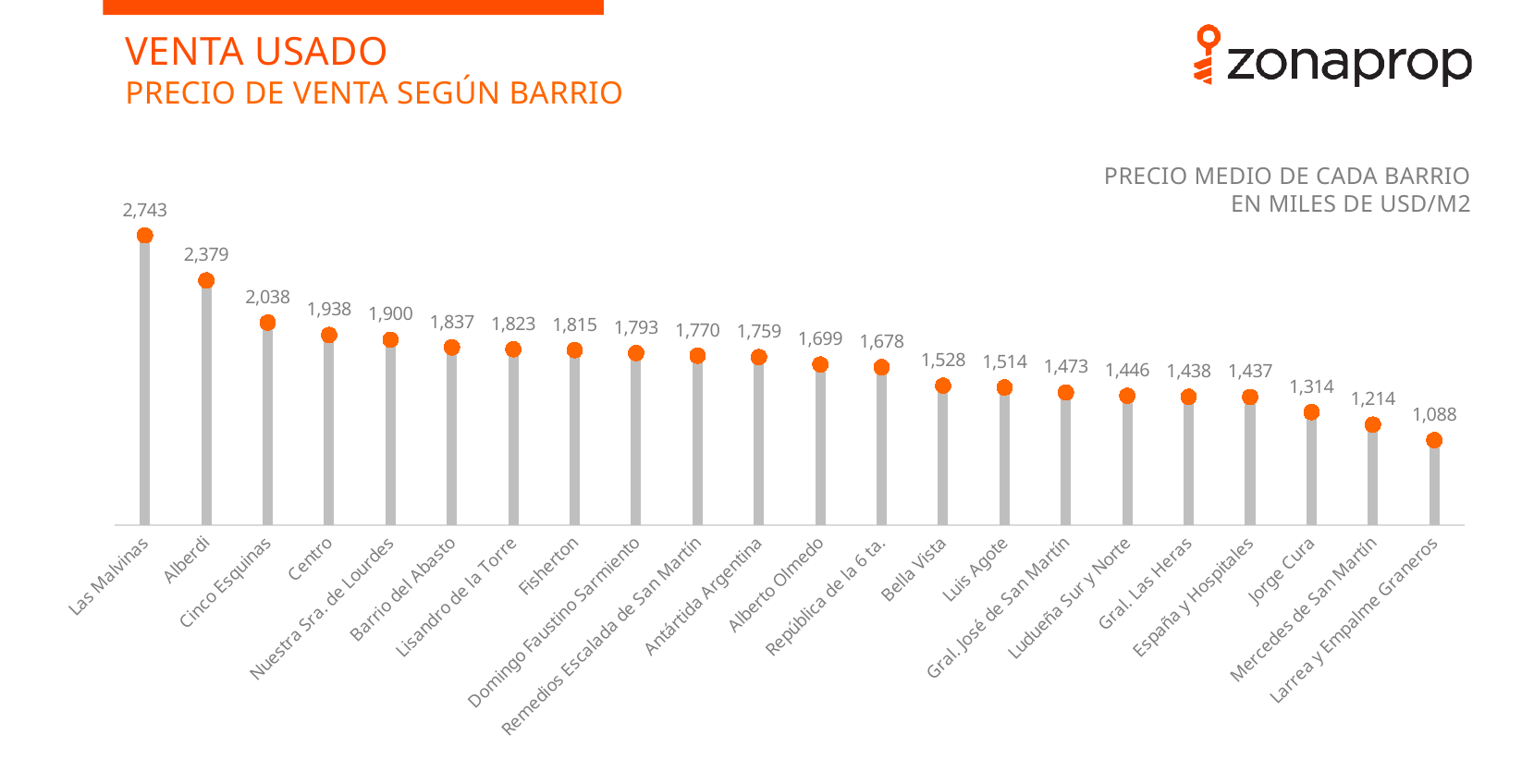
How many barrios are shown on the chart? 22 Which barrio has the lowest value? Larrea y Empalme Graneros What is the value for Bella Vista? 1,528 What unit are the values expressed in, according to the note on the chart? Miles de USD/M2 Which has a larger value, Alberto Olmedo or Luis Agote? Alberto Olmedo What is the value for Las Malvinas? 2,743 Do the values rise or fall from left to right along the x axis? Fall Which barrio has the highest value? Las Malvinas What is the value for Jorge Cura? 1,314 What is the value for Fisherton? 1,815 What is the difference between the values for Las Malvinas and Alberdi? 364 What is the difference between the values for Centro and Cinco Esquinas? 100